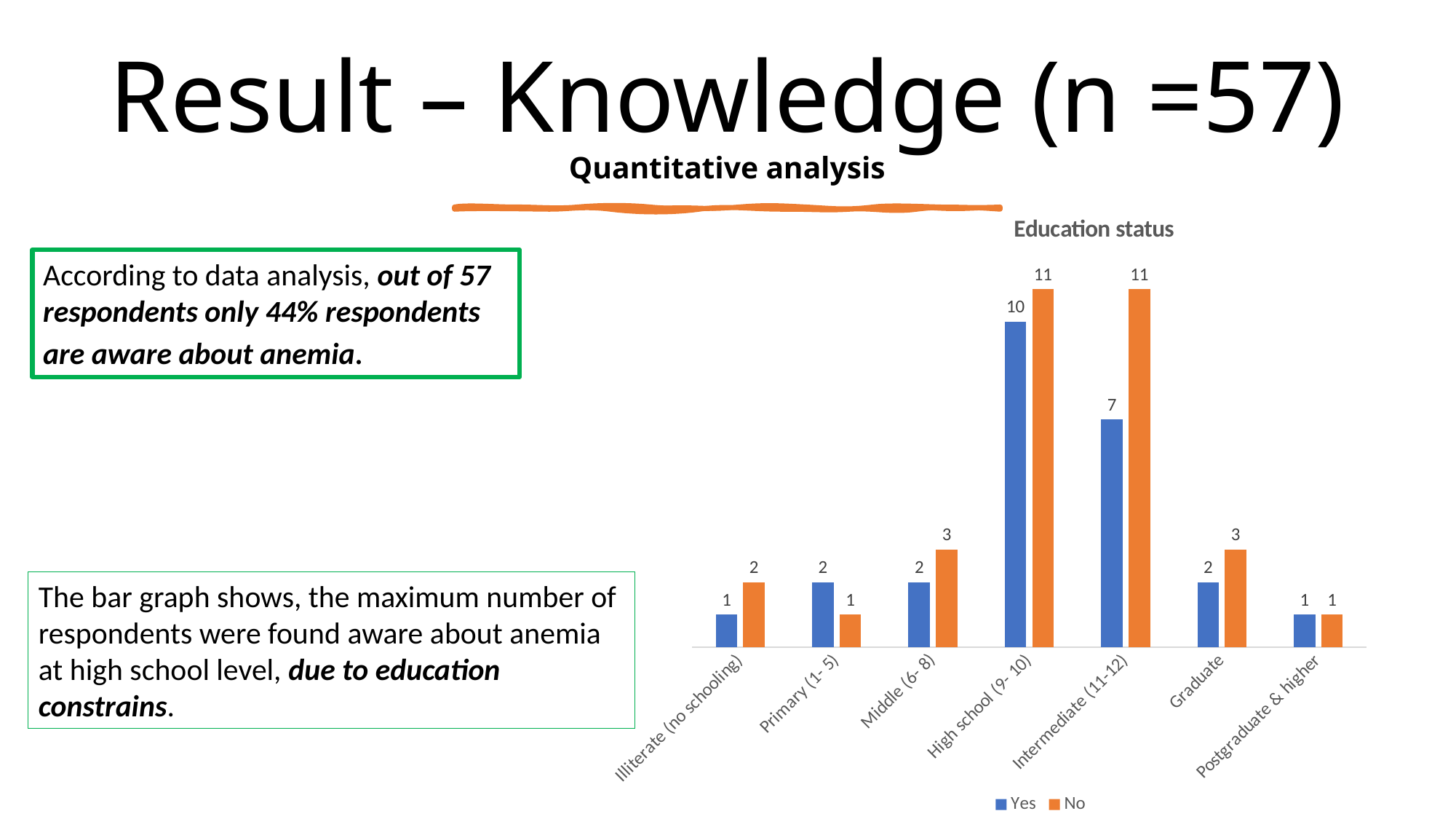
How many series does the legend list? 2 For Primary (1- 5), which series has the larger value, Yes or No? Yes What kind of chart is shown on the slide? Bar chart Which colour represents the No series in the chart? Orange How many education categories are shown on the x axis? 7 What is the difference between the No and Yes values for Intermediate (11-12)? 4 What is the title of the chart? Education status Which category has the lowest value in the No series? Primary (1- 5) and Postgraduate & higher (both 1) Which category has the highest value in the Yes series? High school (9- 10) What is the value of the Yes series for High school (9- 10)? 10 What is the value of the No series for Intermediate (11-12)? 11 What is the value of the Yes series for Graduate? 2